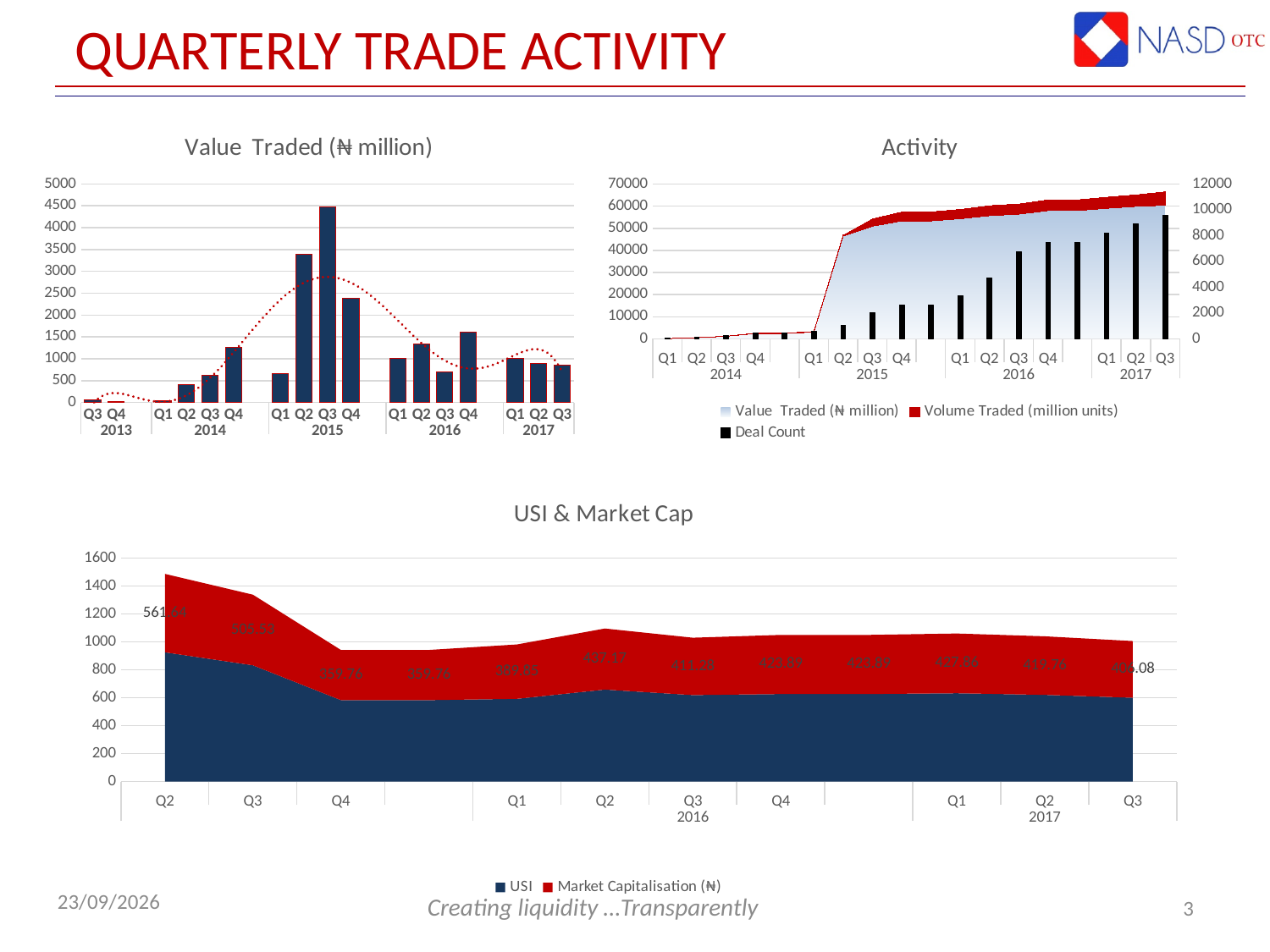
In the 'Value Traded (₦ million)' chart, which quarter has the highest value traded? Q3 2015 In the 'USI & Market Cap' chart, what Market Capitalisation value is labelled for Q3 2017? 406.08 How many series does the legend of the 'USI & Market Cap' chart list? 2 In the 'Activity' chart, what is the maximum value shown on the right-hand axis? 12000 How many quarterly bars are plotted in the 'Value Traded (₦ million)' chart? 17 What kind of chart is the 'Value Traded (₦ million)' chart? bar chart In the 'Value Traded (₦ million)' chart, is the value for Q3 2015 greater or less than 4000? greater In the 'USI & Market Cap' chart, what Market Capitalisation value is labelled for Q2 2015? 561.64 In the 'USI & Market Cap' chart, what is the difference between the labelled Market Capitalisation values for Q2 2015 and Q3 2017? 155.56 How many series does the legend of the 'Activity' chart list? 3 In the 'Activity' chart, which quarter has the highest Deal Count? Q3 2017 In the 'Value Traded (₦ million)' chart, is the value for Q1 2016 greater or less than 1500? less